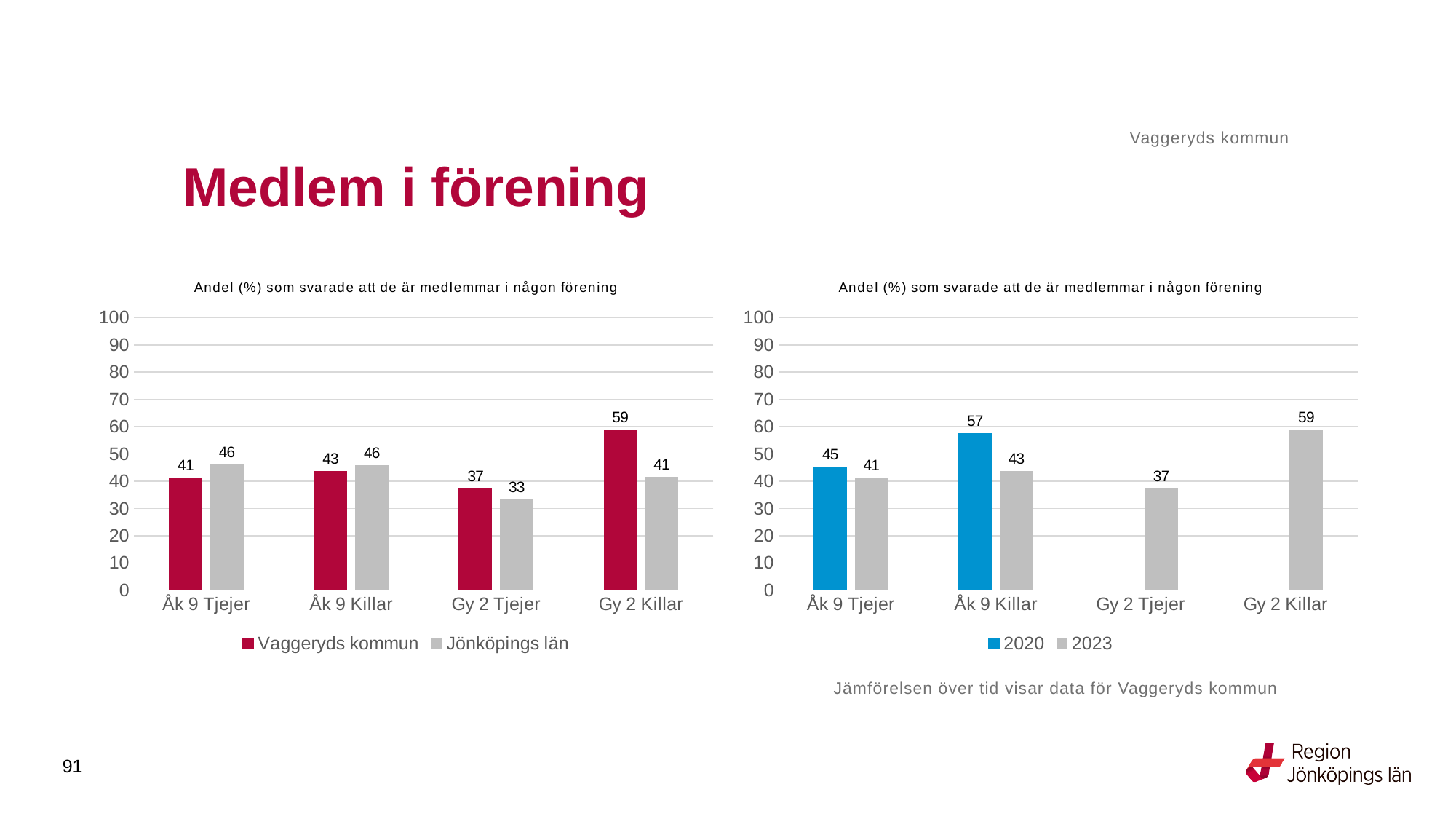
What type of chart is the right chart? Bar chart In the right chart, what is the 2020 value for Åk 9 Killar? 57 In the right chart, what is the 2023 value for Gy 2 Tjejer? 37 In the left chart, which category has the lowest value for Jönköpings län? Gy 2 Tjejer In the left chart, what is the value for Vaggeryds kommun for Gy 2 Killar? 59 In the right chart, what is the difference between the 2020 and 2023 values for Åk 9 Killar? 14 In the right chart, how many series does the legend list? 2 How many categories are shown on the x axis of the left chart? 4 In the left chart, which category has the highest value for Vaggeryds kommun? Gy 2 Killar In the left chart, what is the difference between Vaggeryds kommun and Jönköpings län for Gy 2 Killar? 18 In the left chart, what is the value for Jönköpings län for Gy 2 Tjejer? 33 In the left chart, which is larger for Åk 9 Tjejer: Vaggeryds kommun or Jönköpings län? Jönköpings län